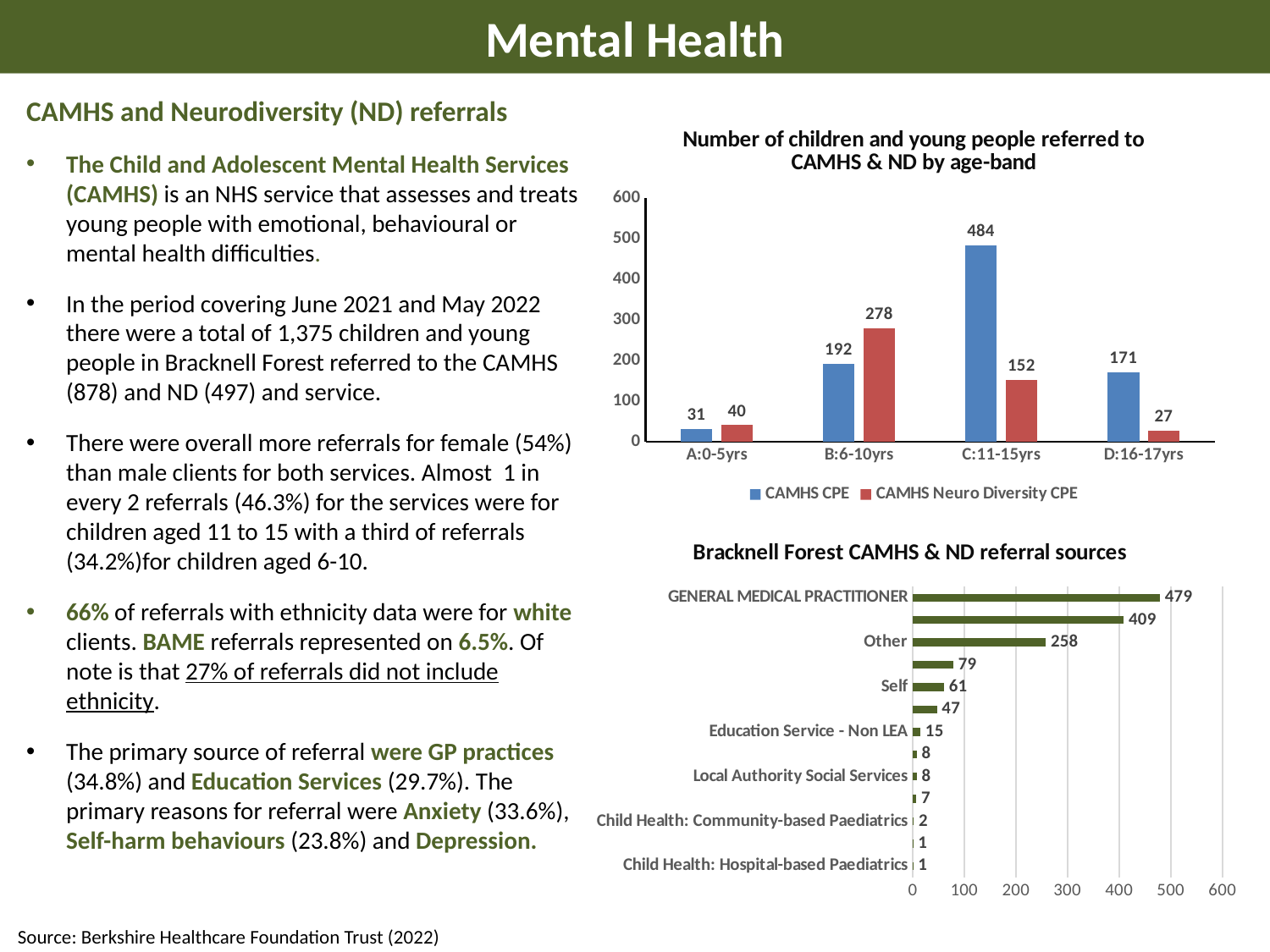
In the 'Number of children and young people referred to CAMHS & ND by age-band' chart, which age-band has the highest CAMHS CPE value? C:11-15yrs In the 'Number of children and young people referred to CAMHS & ND by age-band' chart, which age-band has the lowest CAMHS Neuro Diversity CPE value? D:16-17yrs In the 'Number of children and young people referred to CAMHS & ND by age-band' chart, what is the CAMHS Neuro Diversity CPE value for B:6-10yrs? 278 In the 'Bracknell Forest CAMHS & ND referral sources' chart, what is the value for Self? 61 In the 'Number of children and young people referred to CAMHS & ND by age-band' chart, what is the CAMHS CPE value for C:11-15yrs? 484 In the 'Bracknell Forest CAMHS & ND referral sources' chart, what is the value for GENERAL MEDICAL PRACTITIONER? 479 How many age-band categories are shown in the 'Number of children and young people referred to CAMHS & ND by age-band' chart? 4 How many series does the legend of the 'Number of children and young people referred to CAMHS & ND by age-band' chart list? 2 What type of chart is the 'Bracknell Forest CAMHS & ND referral sources' chart? Bar chart In the 'Number of children and young people referred to CAMHS & ND by age-band' chart, which is larger for A:0-5yrs: CAMHS CPE or CAMHS Neuro Diversity CPE? CAMHS Neuro Diversity CPE In the 'Number of children and young people referred to CAMHS & ND by age-band' chart, what is the difference between the CAMHS CPE and CAMHS Neuro Diversity CPE values for C:11-15yrs? 332 In the 'Bracknell Forest CAMHS & ND referral sources' chart, what is the difference between the values for Other and Education Service - Non LEA? 243